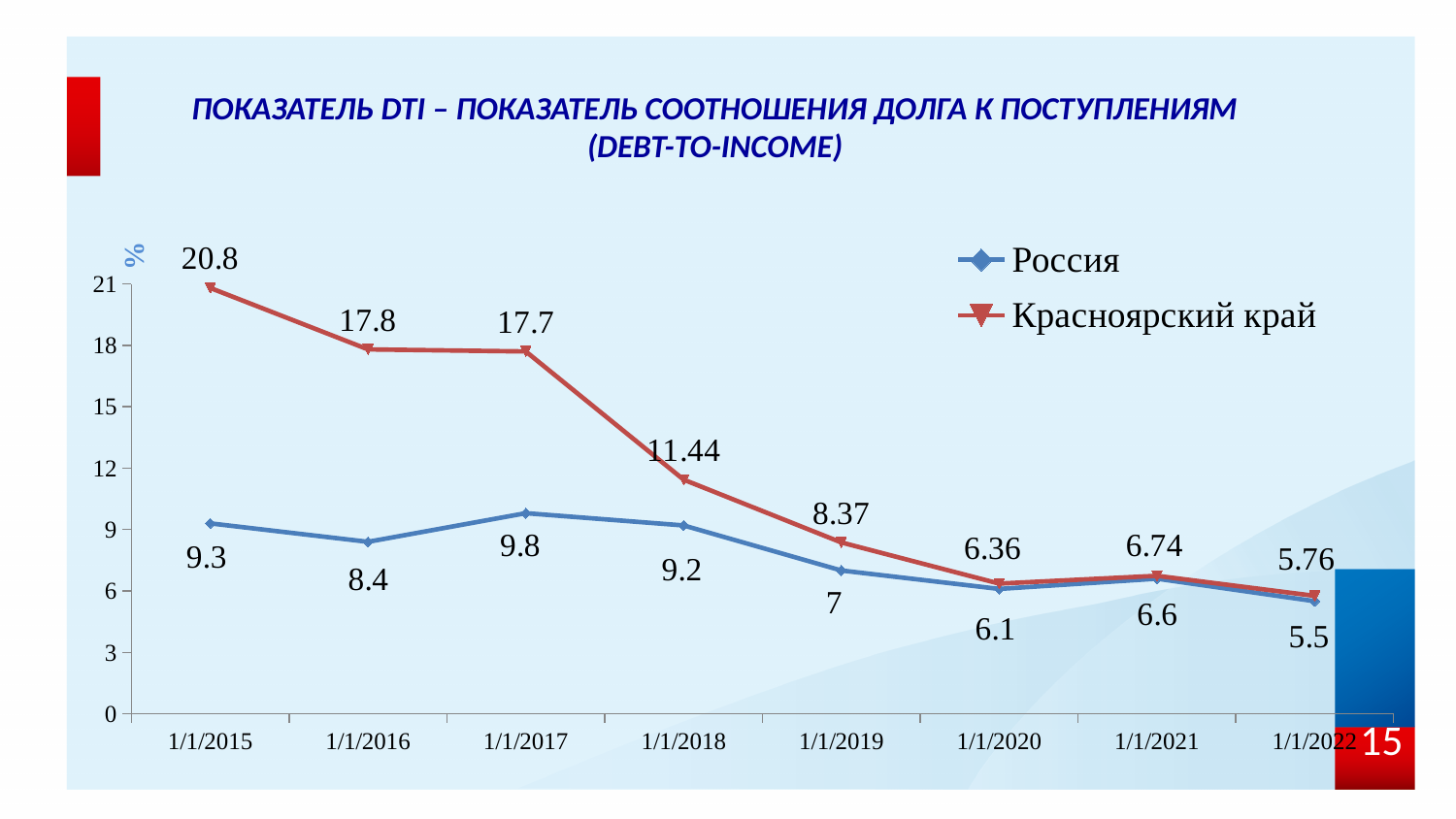
How many series does the legend list? 2 On which date is the value for Россия highest? 1/1/2017 How many dates are shown on the x axis? 8 Which series has the larger value on 1/1/2018, Россия or Красноярский край? Красноярский край What is the value for Красноярский край on 1/1/2015? 20.8 What is the value for Россия on 1/1/2017? 9.8 What is the value for Красноярский край on 1/1/2018? 11.44 What is the difference between the Красноярский край and Россия values on 1/1/2015? 11.5 On which date is the value for Красноярский край lowest? 1/1/2022 What is the value for Россия on 1/1/2022? 5.5 What kind of chart is shown on the slide? line chart Does the value for Красноярский край rise or fall from 1/1/2015 to 1/1/2022? fall